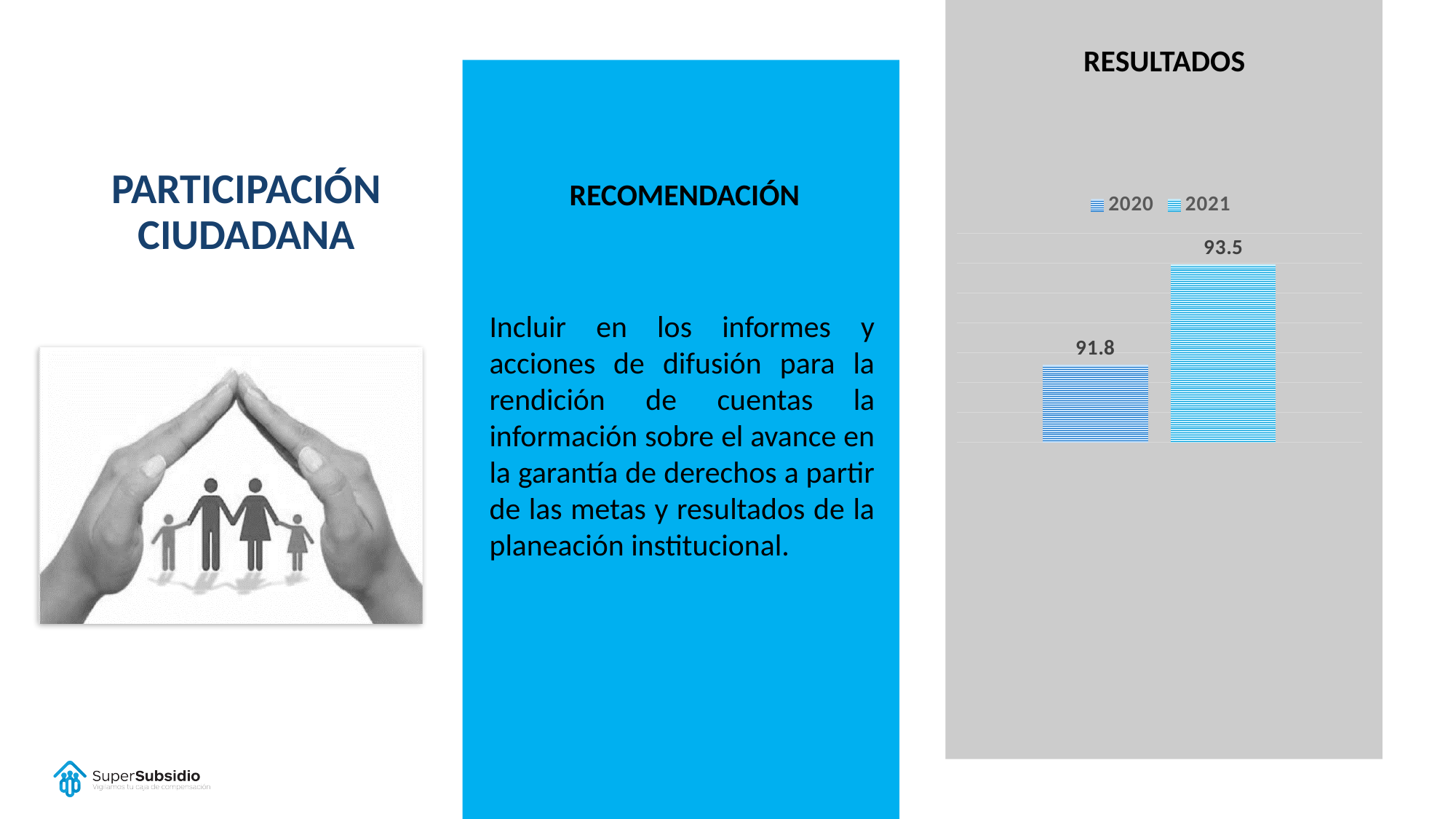
Do the values rise or fall from 2020 to 2021? rise What is the title above the chart? RESULTADOS What is the value for 2020 in the chart? 91.8 Which years are listed in the chart legend? 2020 and 2021 What is the value for 2021 in the chart? 93.5 What is the difference between the 2021 and 2020 values in the chart? 1.7 Which year has the lower value in the chart? 2020 What kind of chart is shown on the slide? bar chart How many bars are plotted in the chart? 2 How many series does the chart legend list? 2 Which year has the higher value in the chart? 2021 Is the value for 2021 larger or smaller than the value for 2020? larger